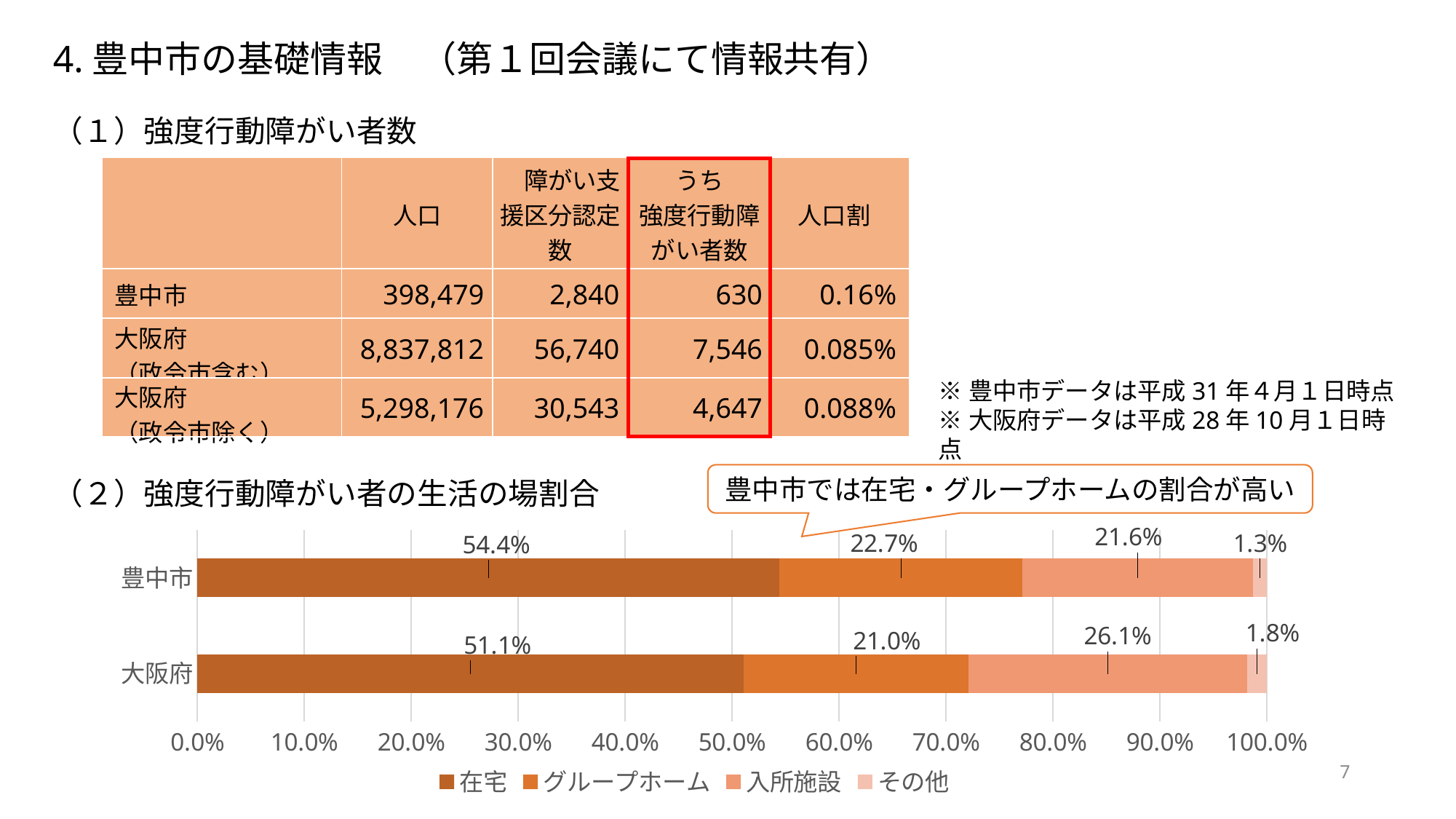
How many series does the chart legend list? 4 How many categories (bars) are plotted in the chart? 2 Which category has the higher 入所施設 share, 豊中市 or 大阪府? 大阪府 Which series is the smallest segment in the 豊中市 bar? その他 What is the 入所施設 share for 豊中市 in the chart? 21.6% What is the difference between the 入所施設 shares of 大阪府 and 豊中市? 4.5% What is the first series listed in the chart legend? 在宅 Which category has the higher 在宅 share, 豊中市 or 大阪府? 豊中市 What is the グループホーム share for 大阪府 in the chart? 21.0% What is the 在宅 share for 豊中市 in the chart? 54.4% What is the その他 share for 大阪府 in the chart? 1.8% What kind of chart is shown on the slide? Stacked bar chart